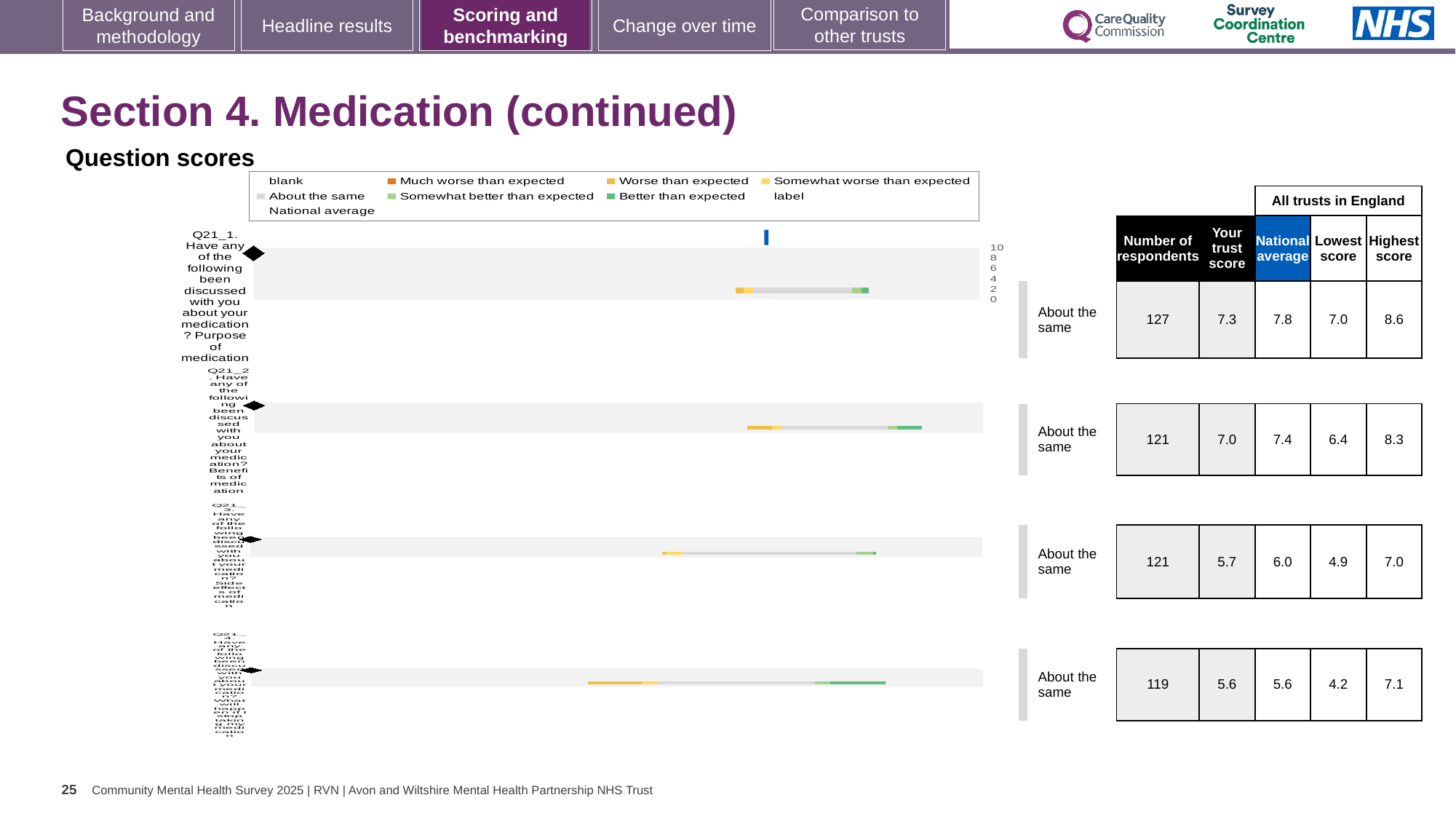
What is the highest score across all trusts in England for Q21_2 (Benefits of medication)? 8.3 For Q21_1 (Purpose of medication), what is the difference between the national average and the trust score? 0.5 Which question has the lowest 'Your trust score'? Q21_4 What benchmark category is shown for all four questions in the chart? About the same Which question has the highest 'Your trust score'? Q21_1 (Purpose of medication) What kind of chart is used to show the question scores on this slide? bar chart What is the 'Your trust score' for Q21_1 (Purpose of medication)? 7.3 How many respondents answered the fourth row question, Q21_4? 119 For Q21_2 (Benefits of medication), which is larger: the trust score or the national average? National average What is the national average for the third row, Q21_3? 6.0 What colour does the legend use for 'Better than expected'? Green How many questions (bars) are plotted in the question scores chart? 4